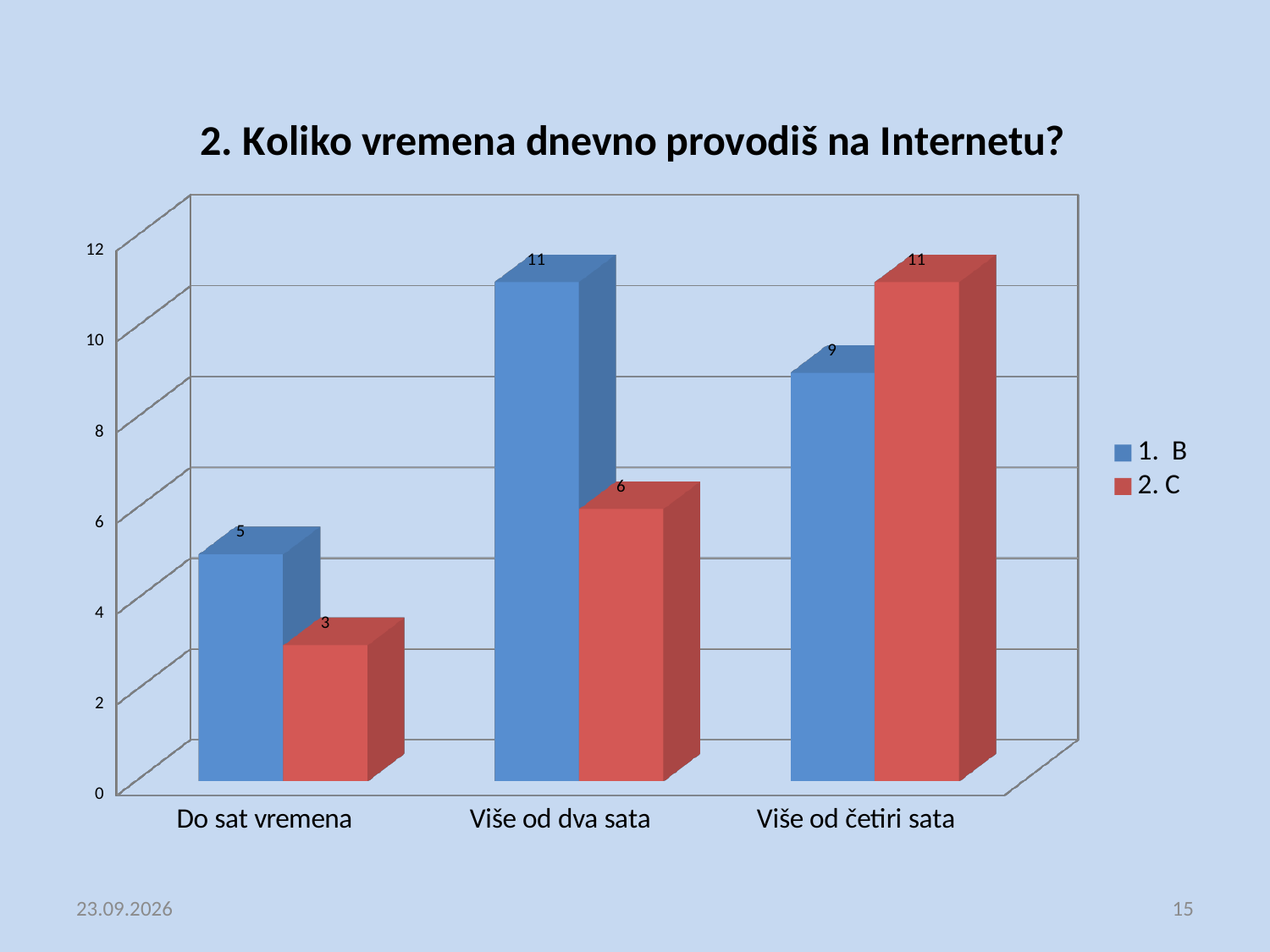
How many series does the legend list? 2 How many categories are shown on the x axis? 3 What is the difference between the "1. B" and "2. C" values in the "Više od dva sata" category? 5 What is the value for series "2. C" in the "Do sat vremena" category? 3 What kind of chart is shown on the slide? Bar chart What is the value for series "2. C" in the "Više od dva sata" category? 6 Which category has the lowest value for series "2. C"? Do sat vremena What is the title of the chart? 2. Koliko vremena dnevno provodiš na Internetu? In the "Više od četiri sata" category, which series has the larger value, "1. B" or "2. C"? 2. C What is the value for series "1. B" in the "Do sat vremena" category? 5 Which category has the highest value for series "1. B"? Više od dva sata What is the value for series "1. B" in the "Više od četiri sata" category? 9